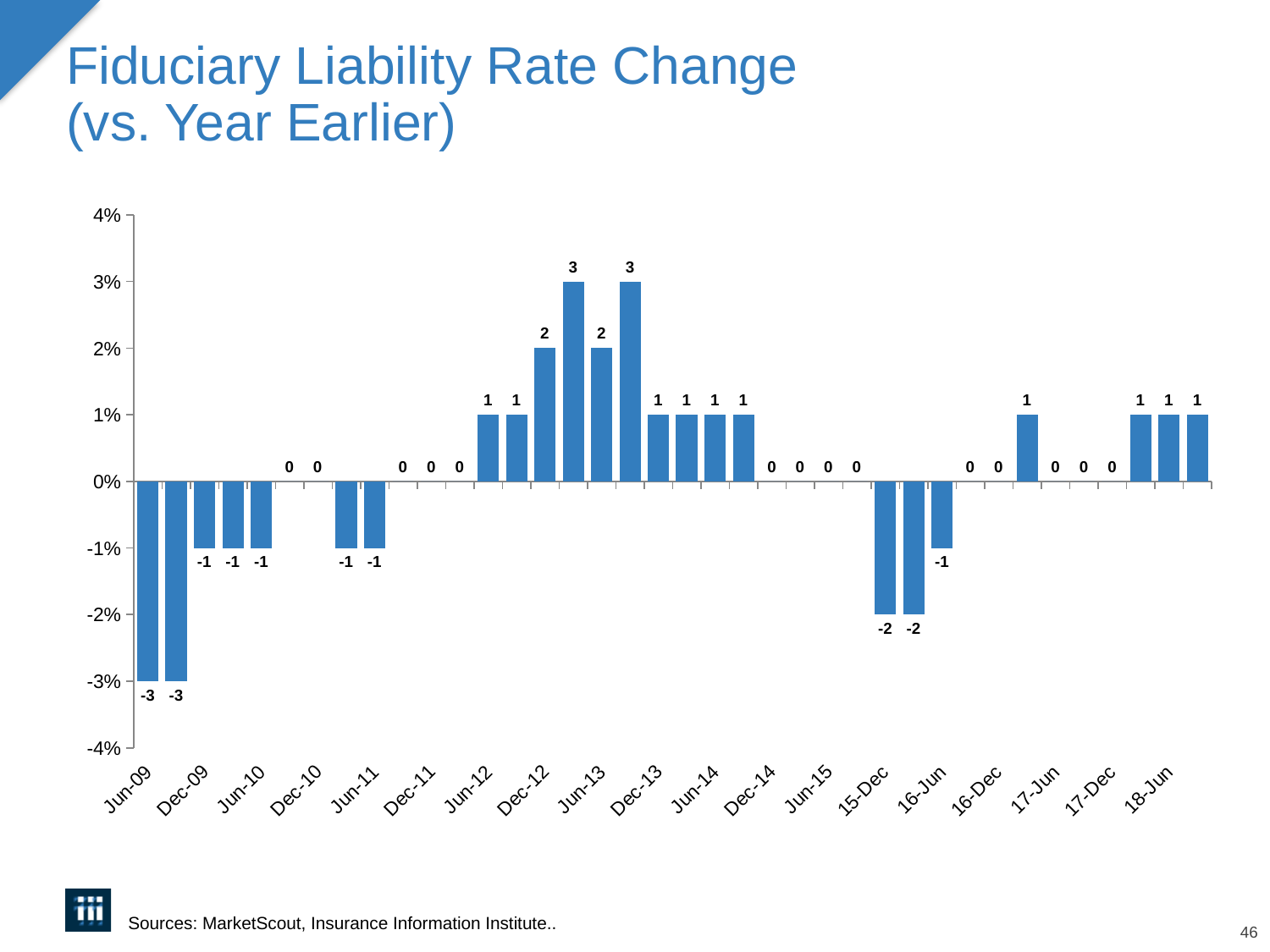
What is the rate change value for Jun-09? -3 What is the rate change value for Jun-15? 0 What is the lowest data label value shown on the chart? -3 What is the rate change value for Jun-14? 1 What is the title of the chart? Fiduciary Liability Rate Change (vs. Year Earlier) How many bars are plotted on the chart? 38 Is the value for Jun-09 greater or less than -2%? less Which has the larger value, Jun-14 or Jun-15? Jun-14 What is the highest data label value shown on the chart? 3 What type of chart is shown on the slide? Bar chart What is the rate change value for 18-Jun? 1 What is the difference between the value for 18-Jun and the value for Jun-09? 4